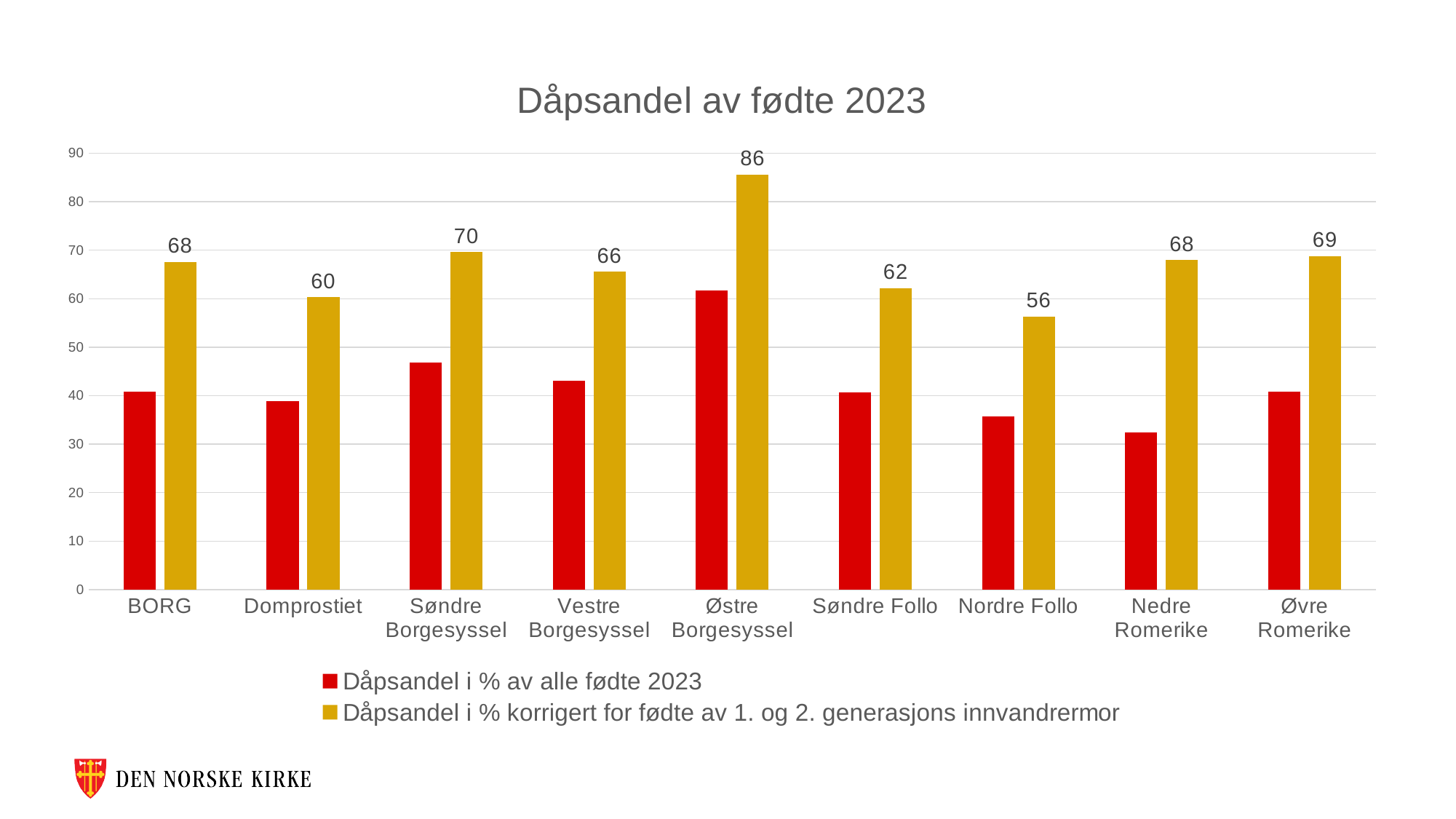
What is the difference between the corrected values for Østre Borgesyssel and Nordre Follo? 30 Which category has the highest value in the 'Dåpsandel i % korrigert for fødte av 1. og 2. generasjons innvandrermor' series? Østre Borgesyssel What is the value of the 'Dåpsandel i % korrigert for fødte av 1. og 2. generasjons innvandrermor' series for Domprostiet? 60 Is the value of 'Dåpsandel i % av alle fødte 2023' for Nedre Romerike greater or less than 40? less Is the value of 'Dåpsandel i % av alle fødte 2023' for Østre Borgesyssel greater or less than 50? greater Which category has the lowest value in the 'Dåpsandel i % korrigert for fødte av 1. og 2. generasjons innvandrermor' series? Nordre Follo What is the value of the 'Dåpsandel i % korrigert for fødte av 1. og 2. generasjons innvandrermor' series for Østre Borgesyssel? 86 How many categories are shown on the x axis? 9 In the corrected series, which is larger: Søndre Borgesyssel or Vestre Borgesyssel? Søndre Borgesyssel What is the value of the 'Dåpsandel i % korrigert for fødte av 1. og 2. generasjons innvandrermor' series for Nordre Follo? 56 How many series does the legend list? 2 What type of chart is shown on the slide? Bar chart